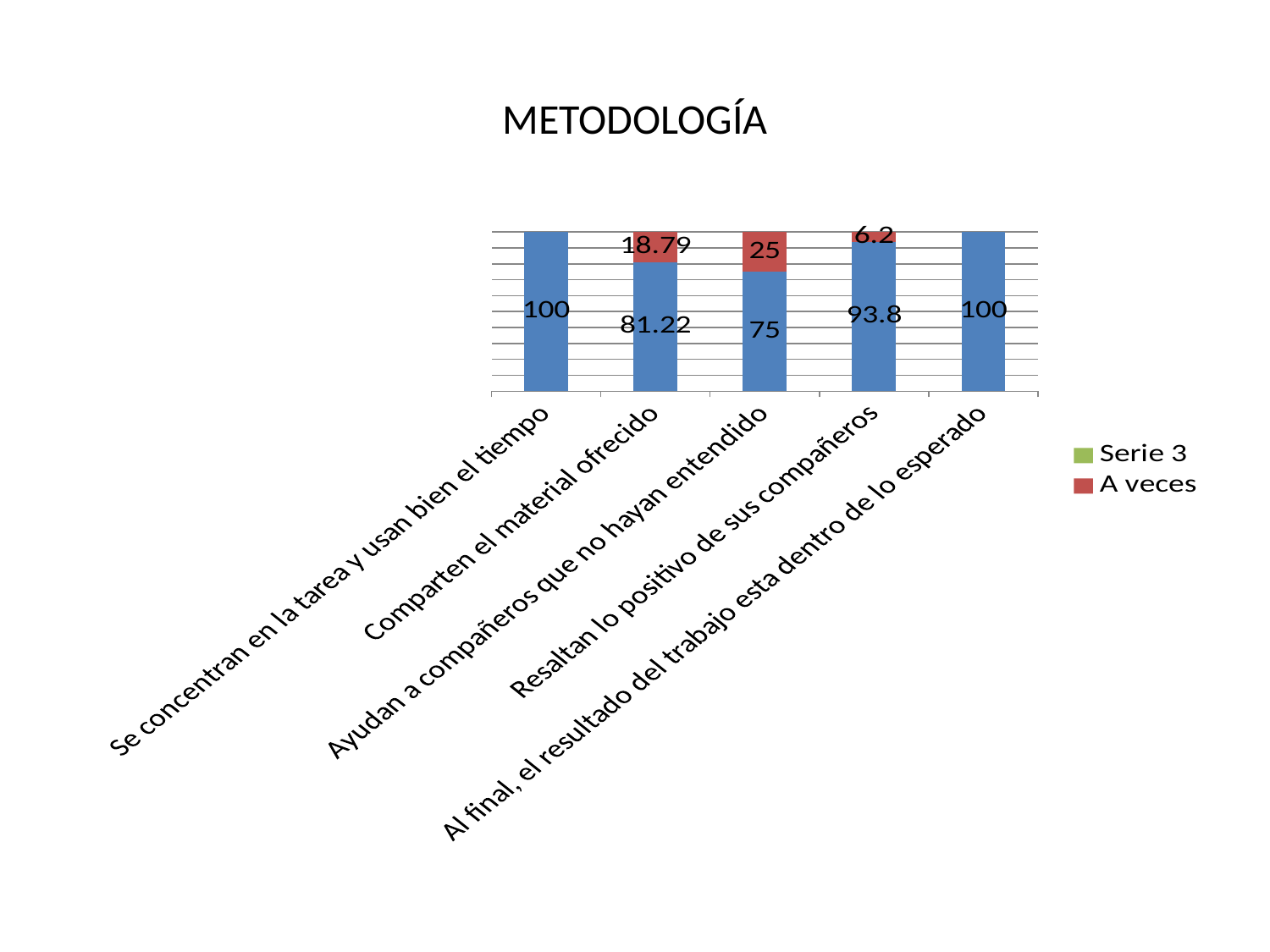
What is the value of the 'A veces' segment for 'Comparten el material ofrecido'? 18.79 What is the value of the 'A veces' segment for 'Ayudan a compañeros que no hayan entendido'? 25 How many series does the legend list? 2 What is the value of the blue segment for 'Resaltan lo positivo de sus compañeros'? 93.8 What is the value of the blue segment for 'Comparten el material ofrecido'? 81.22 What type of chart is shown on the slide? Stacked bar chart What is the total of the stacked bar for 'Ayudan a compañeros que no hayan entendido'? 100 How many categories are shown on the x axis of the chart? 5 What is the title of the chart? METODOLOGÍA Which category has the largest 'A veces' segment? Ayudan a compañeros que no hayan entendido What is the value of the 'A veces' segment for 'Resaltan lo positivo de sus compañeros'? 6.2 Which category has the smallest blue segment? Ayudan a compañeros que no hayan entendido